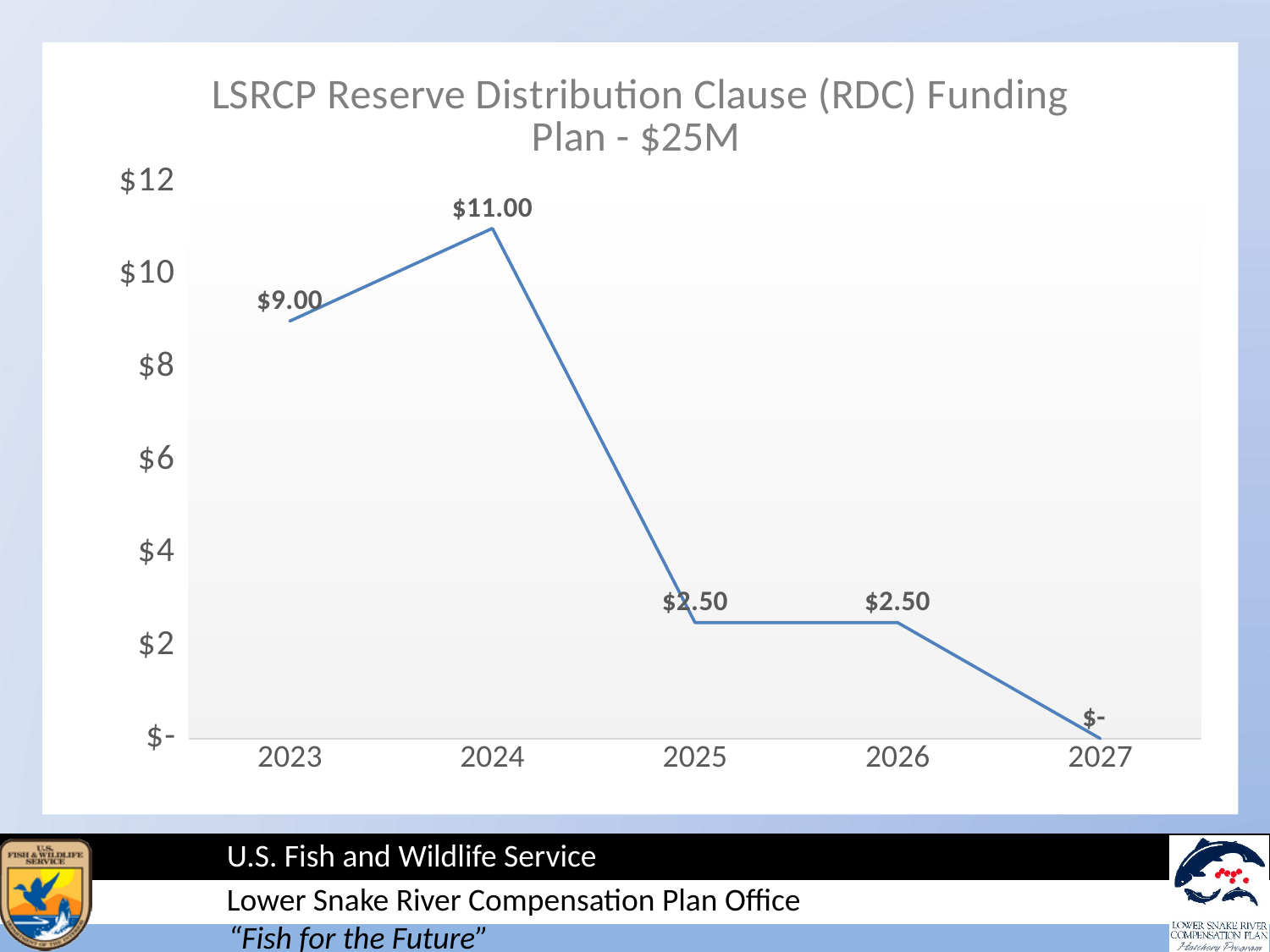
What is the value for 2023? $9.00 What is the difference between the values for 2024 and 2023? $2.00 Which is larger, the value for 2023 or the value for 2025? 2023 Which year has the highest value? 2024 What is the value for 2024? $11.00 What is the difference between the values for 2024 and 2025? $8.50 Which year has the lowest value? 2027 What kind of chart is shown? line chart What is the value for 2026? $2.50 Is the value for 2025 greater or less than $4? less How many years are plotted on the chart? 5 What is the title of the chart? LSRCP Reserve Distribution Clause (RDC) Funding Plan - $25M